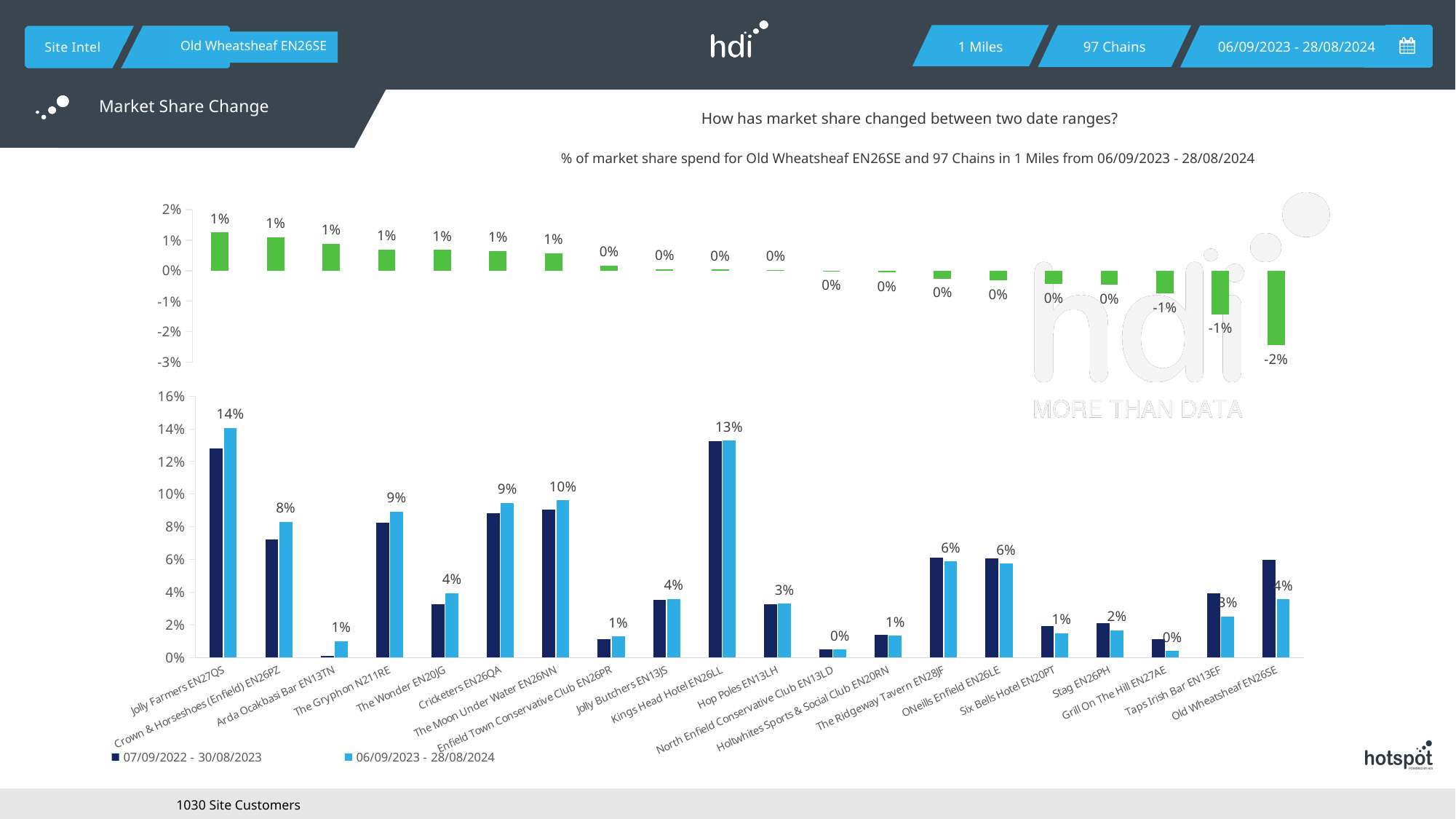
How many series does the legend of the bottom chart list? 2 In the bottom chart, what is the labelled market share for The Moon Under Water EN26NN in the 06/09/2023 - 28/08/2024 period? 10% What kind of chart is the bottom chart? Bar chart In the bottom chart, which has the larger labelled 06/09/2023 - 28/08/2024 value: The Ridgeway Tavern EN28JF or Six Bells Hotel EN20PT? The Ridgeway Tavern EN28JF In the top chart, what is the lowest labelled market share change? -2% In the bottom chart, what is the difference between the labelled 06/09/2023 - 28/08/2024 values for The Moon Under Water EN26NN and Cricketers EN26QA? 1% In the bottom chart, which venue has the highest labelled market share for 06/09/2023 - 28/08/2024? Jolly Farmers EN27QS What are the two date ranges listed in the legend of the bottom chart? 07/09/2022 - 30/08/2023 and 06/09/2023 - 28/08/2024 In the bottom chart, what is the labelled market share for Kings Head Hotel EN26LL in the 06/09/2023 - 28/08/2024 period? 13% In the bottom chart, what is the labelled market share for Jolly Farmers EN27QS in the 06/09/2023 - 28/08/2024 period? 14% How many venues are shown along the x axis of the bottom chart? 20 In the bottom chart, is the 07/09/2022 - 30/08/2023 value for Crown & Horseshoes (Enfield) EN26PZ greater or less than 6%? greater